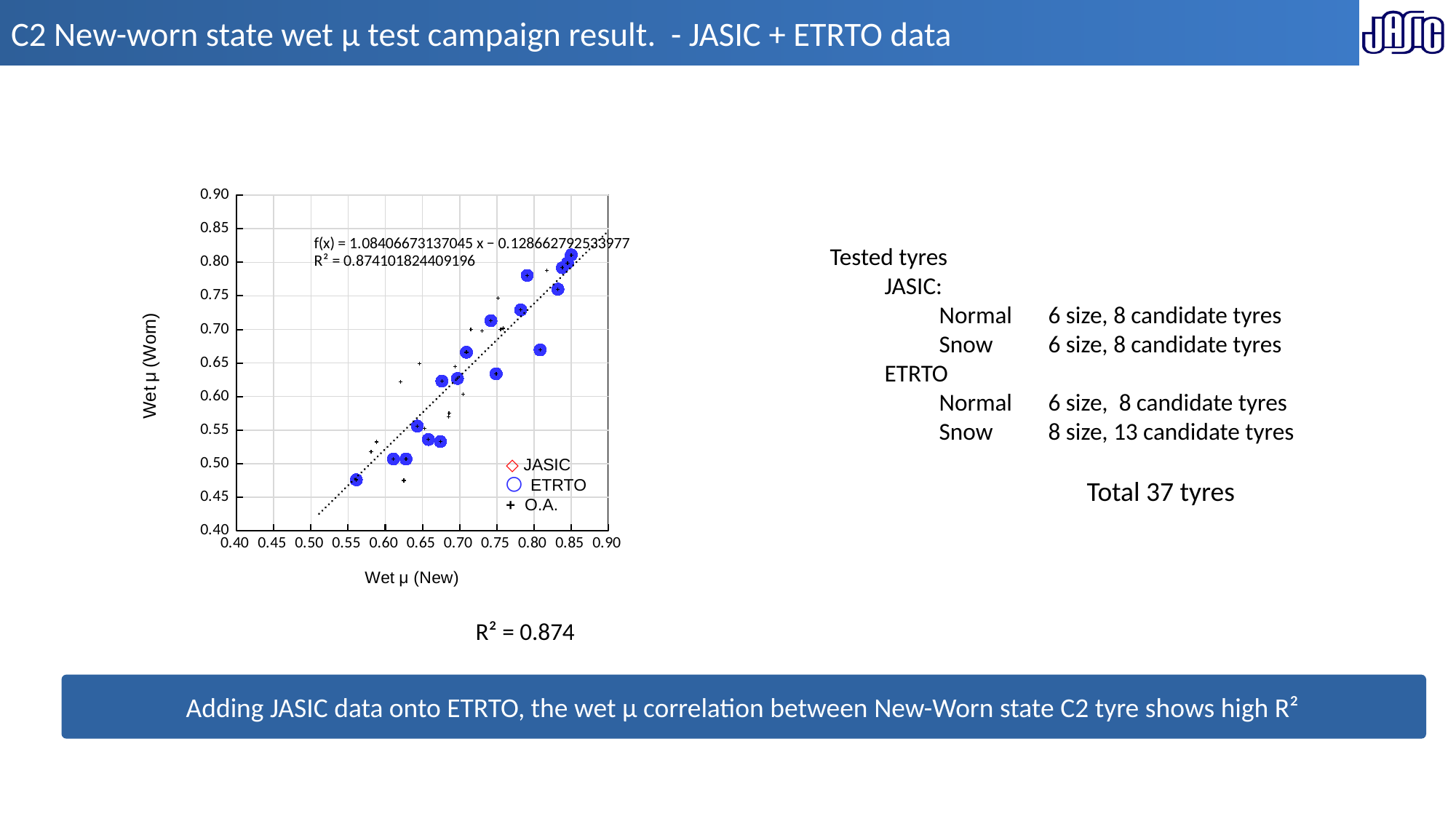
What rounded R² value is printed below the chart? R² = 0.874 What is the maximum value shown on the vertical axis of the chart? 0.90 What R² value is printed on the chart for the trendline? 0.874101824409196 Is the lowest plotted Wet μ (Worn) value greater or less than 0.50? less What kind of chart is shown on the slide? Scatter chart What is the title of the chart's horizontal axis? Wet μ (New) What are the three series named in the chart legend? JASIC, ETRTO, O.A. What is the minimum value shown on the horizontal axis of the chart? 0.40 Is the lowest plotted Wet μ (New) value greater or less than 0.60? less Do the plotted Wet μ (Worn) values generally rise or fall as Wet μ (New) increases? Rise What is the trendline equation printed on the chart? f(x) = 1.08406673137045 x − 0.128662792533977 How many series does the chart legend list? 3